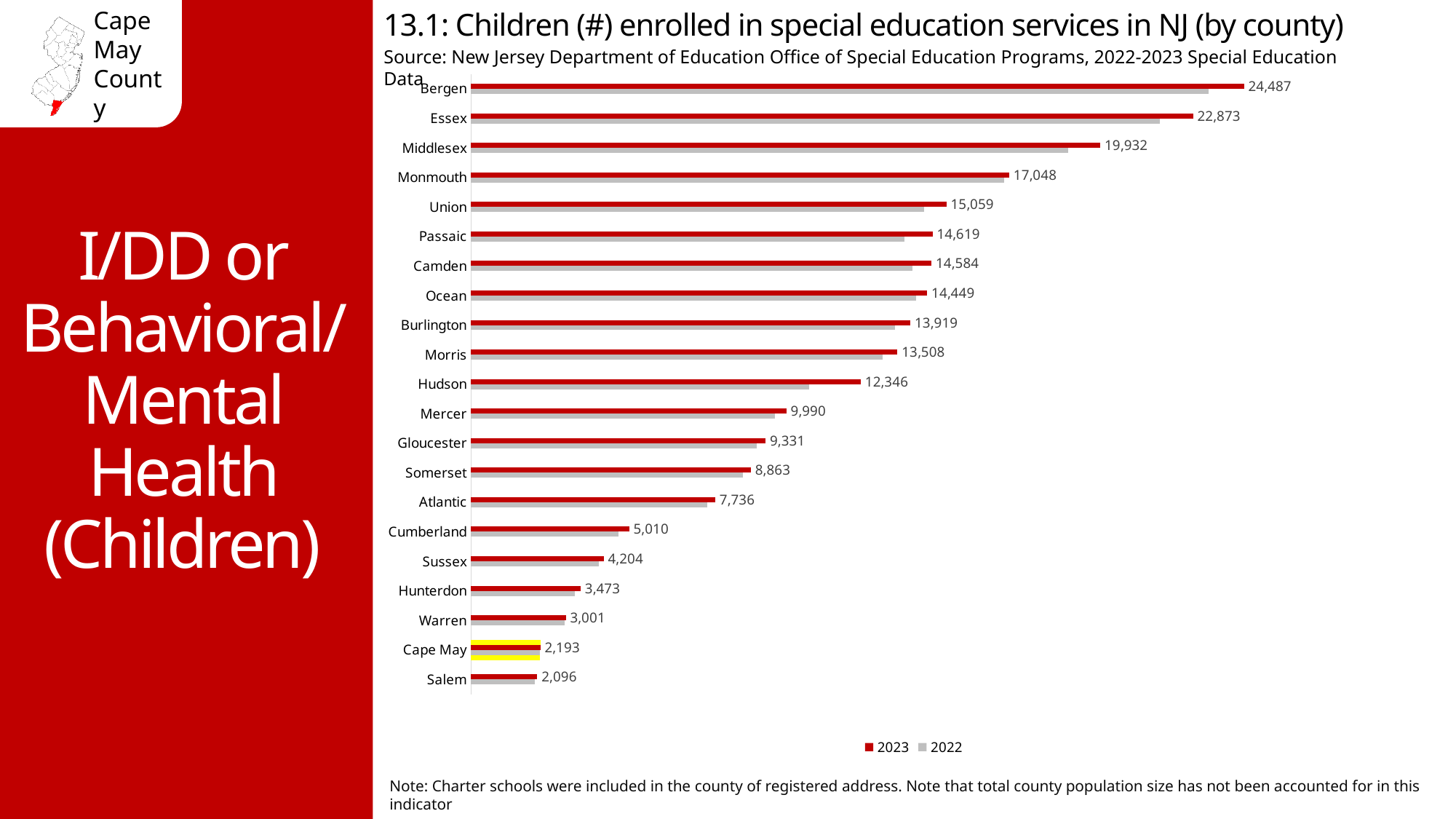
What is the difference between the 2023 values for Cape May and Salem? 97 Which county has the highest 2023 value? Bergen What is the 2023 value for Monmouth? 17,048 How many series does the legend list? 2 What is the difference between the 2023 values for Bergen and Essex? 1,614 Which has a larger 2023 value, Hudson or Mercer? Hudson How many counties are shown in the chart? 21 Which series is shown in red in the legend? 2023 What is the 2023 value for Cape May? 2,193 What kind of chart is shown on the slide? bar chart What is the 2023 value for Cumberland? 5,010 Which county has the lowest 2023 value? Salem